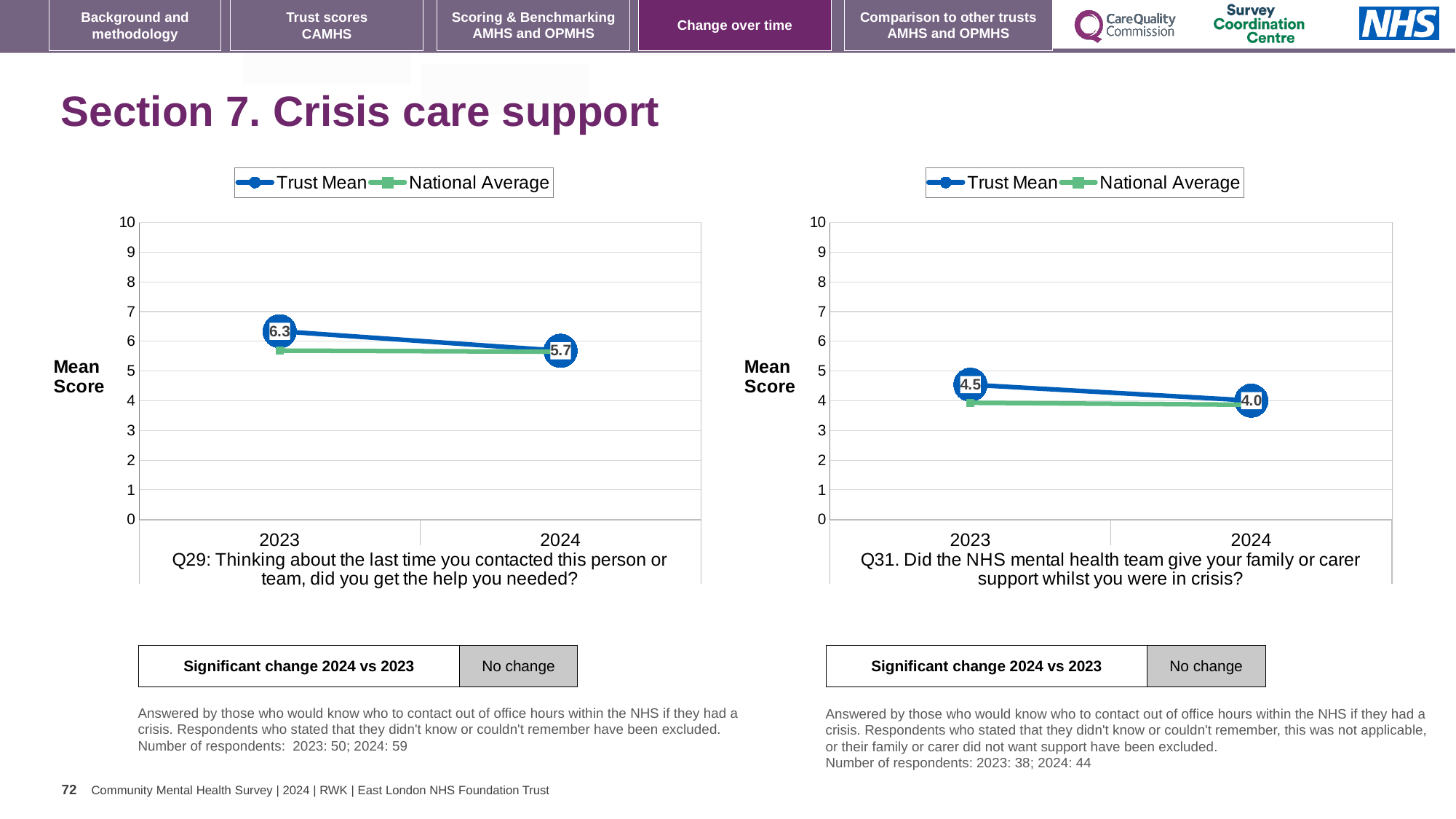
In the Q29 chart on the left, by how much did the Trust Mean change from 2023 to 2024? 0.6 How many years are shown on the x axis of the Q31 chart on the right? 2 What kind of chart is the Q31 chart on the right? line chart How many series does the legend of the Q29 chart on the left list? 2 In the Q29 chart on the left, what is the Trust Mean for 2023? 6.3 In the Q29 chart on the left, is the National Average for 2023 greater or less than 7? less In the Q31 chart on the right, what is the difference between the Trust Mean in 2023 and in 2024? 0.5 In the Q29 chart on the left, what is the Trust Mean for 2024? 5.7 In the Q31 chart on the right, what is the Trust Mean for 2024? 4.0 In the Q31 chart on the right, what is the Trust Mean for 2023? 4.5 In the Q29 chart on the left, does the Trust Mean rise or fall from 2023 to 2024? fall In the Q31 chart on the right, is the Trust Mean for 2023 greater or less than 5? less